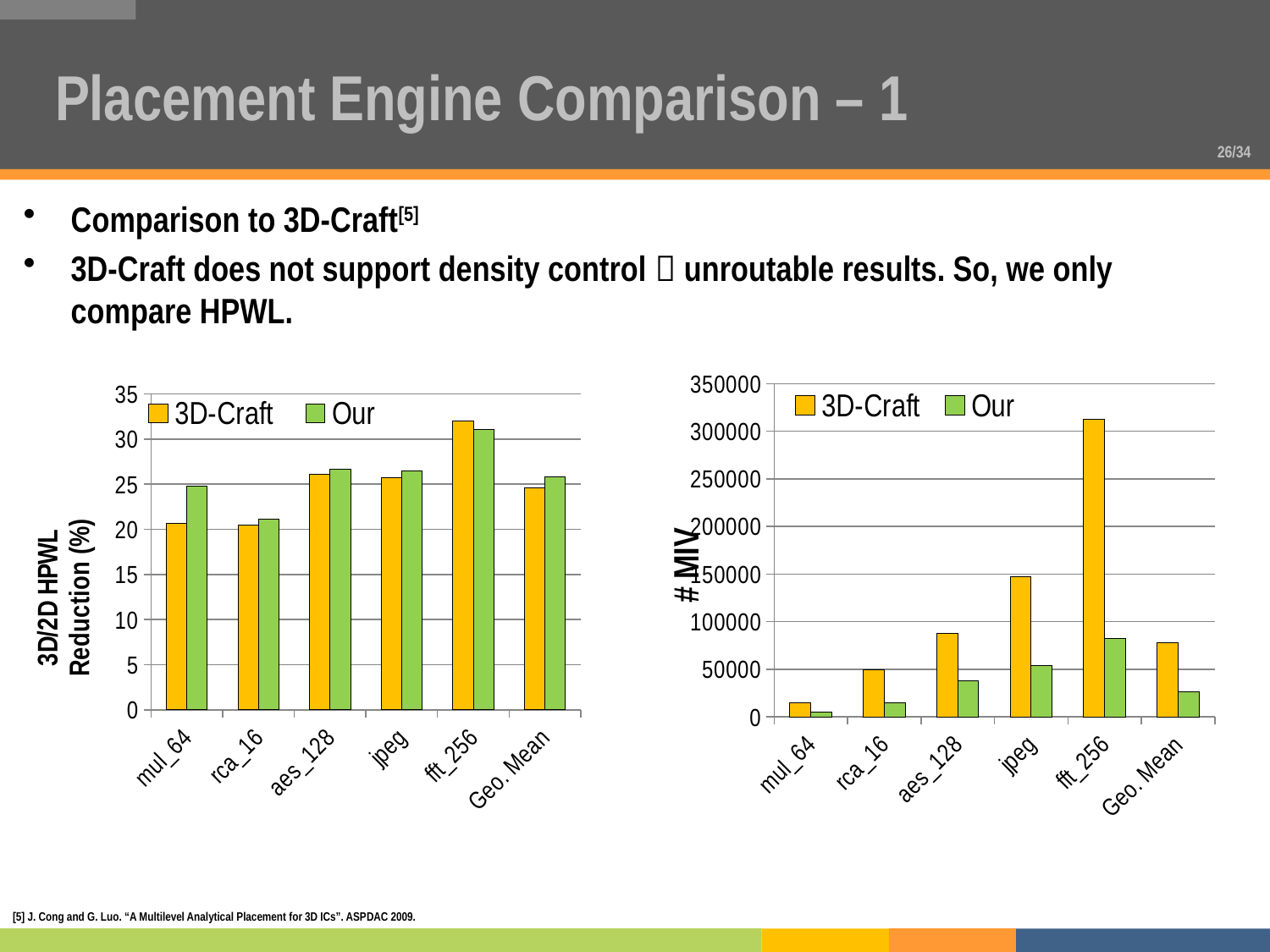
What are the two legend entries in the right chart (# MIV)? 3D-Craft and Our In the right chart (# MIV), which category has the lowest value for Our? mul_64 In the right chart (# MIV), which is larger for jpeg: 3D-Craft or Our? 3D-Craft In the left chart (3D/2D HPWL Reduction), which is larger for mul_64: 3D-Craft or Our? Our In the right chart (# MIV), which category has the highest 3D-Craft value? fft_256 In the right chart (# MIV), is the Our value for Geo. Mean greater or less than 50000? less In the right chart (# MIV), is the 3D-Craft value for fft_256 greater or less than 300000? greater In the left chart (3D/2D HPWL Reduction), is the 3D-Craft value for fft_256 greater or less than 30? greater How many categories are shown on the x axis of the right chart (# MIV)? 6 How many series does the legend of the left chart (3D/2D HPWL Reduction) list? 2 What kind of chart is the left chart showing 3D/2D HPWL Reduction (%)? bar chart What is the y-axis label of the right chart? # MIV